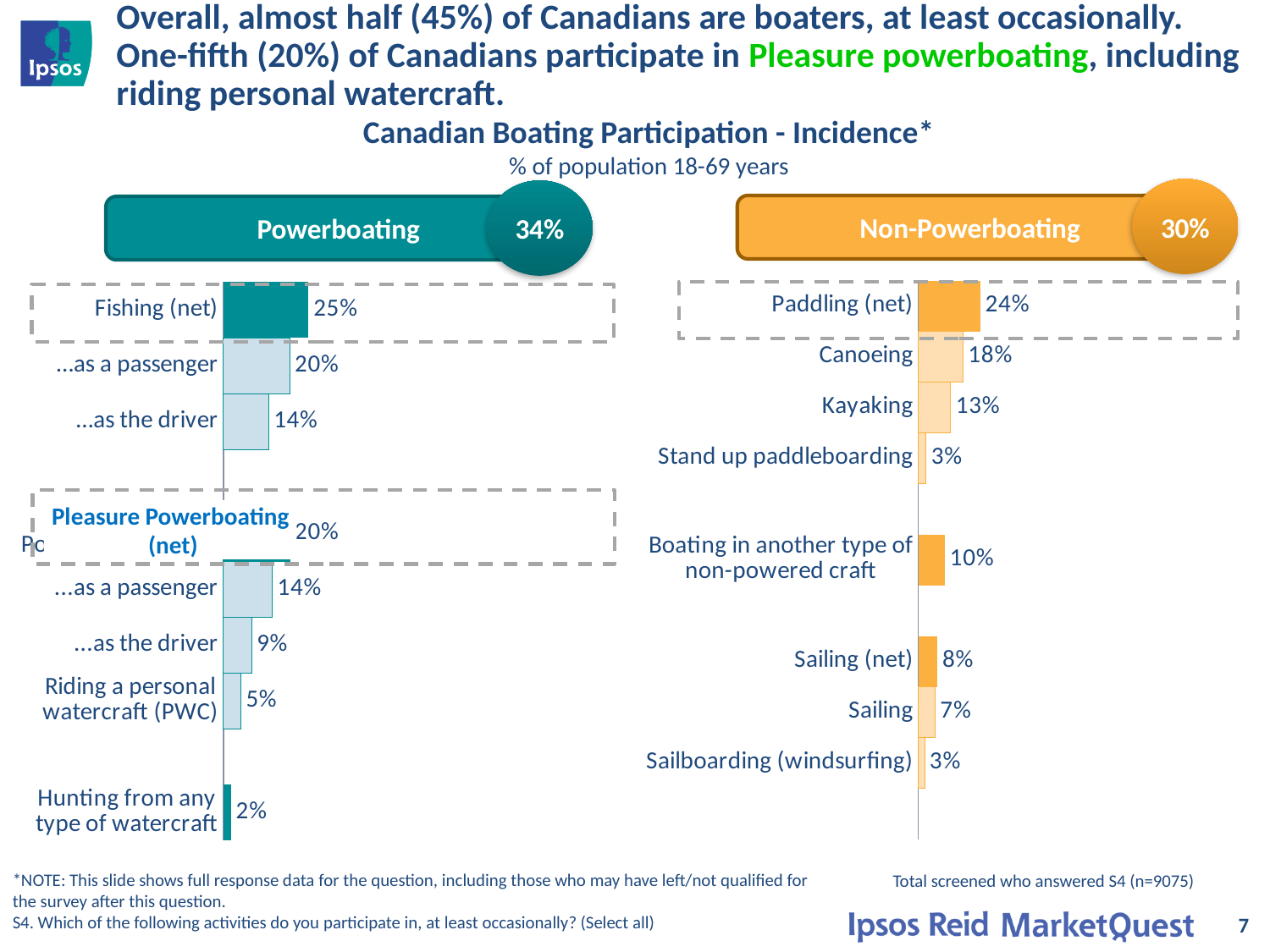
In the Powerboating chart, what is the difference between Fishing (net) and Pleasure Powerboating (net)? 5% In the Non-Powerboating chart, which is larger, Sailing (net) or Boating in another type of non-powered craft? Boating in another type of non-powered craft How many categories are plotted in the Non-Powerboating chart? 8 In the Powerboating chart, what is the value for Riding a personal watercraft (PWC)? 5% In the Non-Powerboating chart, which category has the highest value? Paddling (net) In the Powerboating chart, which category has the lowest value? Hunting from any type of watercraft What overall percentage is shown in the circle next to the Non-Powerboating header? 30% In the Non-Powerboating chart, what is the value for Kayaking? 13% In the Non-Powerboating chart, what is the value for Boating in another type of non-powered craft? 10% In the Non-Powerboating chart, what is the difference between Canoeing and Kayaking? 5% What type of chart is the Powerboating chart? Bar chart In the Powerboating chart, what is the value for Fishing (net)? 25%